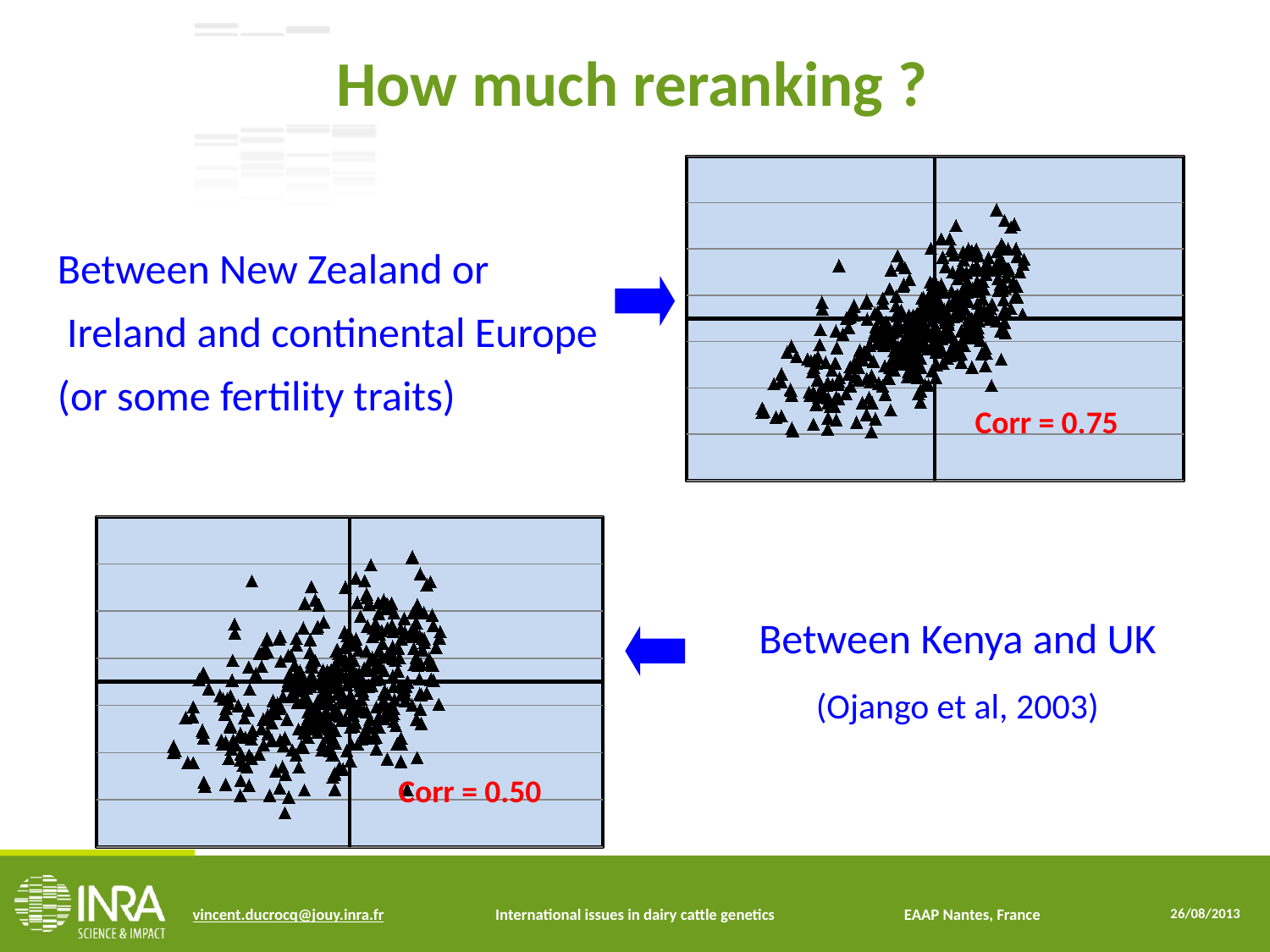
What colour is the plot background of the top-right chart? light blue What correlation value is printed on the top-right chart? Corr = 0.75 In the top-right chart, do the points tend to rise or fall from left to right? rise What marker shape is used for the data points in the bottom-left chart? triangles Which chart shows the higher correlation, the top-right chart or the bottom-left chart? top-right chart What correlation value is printed on the bottom-left chart? Corr = 0.50 What kind of chart is the bottom-left chart on the slide? scatter plot In the bottom-left chart, do the points tend to rise or fall from left to right? rise What kind of chart is the top-right chart on the slide? scatter plot How many scatter plots are shown on the slide? 2 What is the difference between the correlation printed on the top-right chart and the correlation printed on the bottom-left chart? 0.25